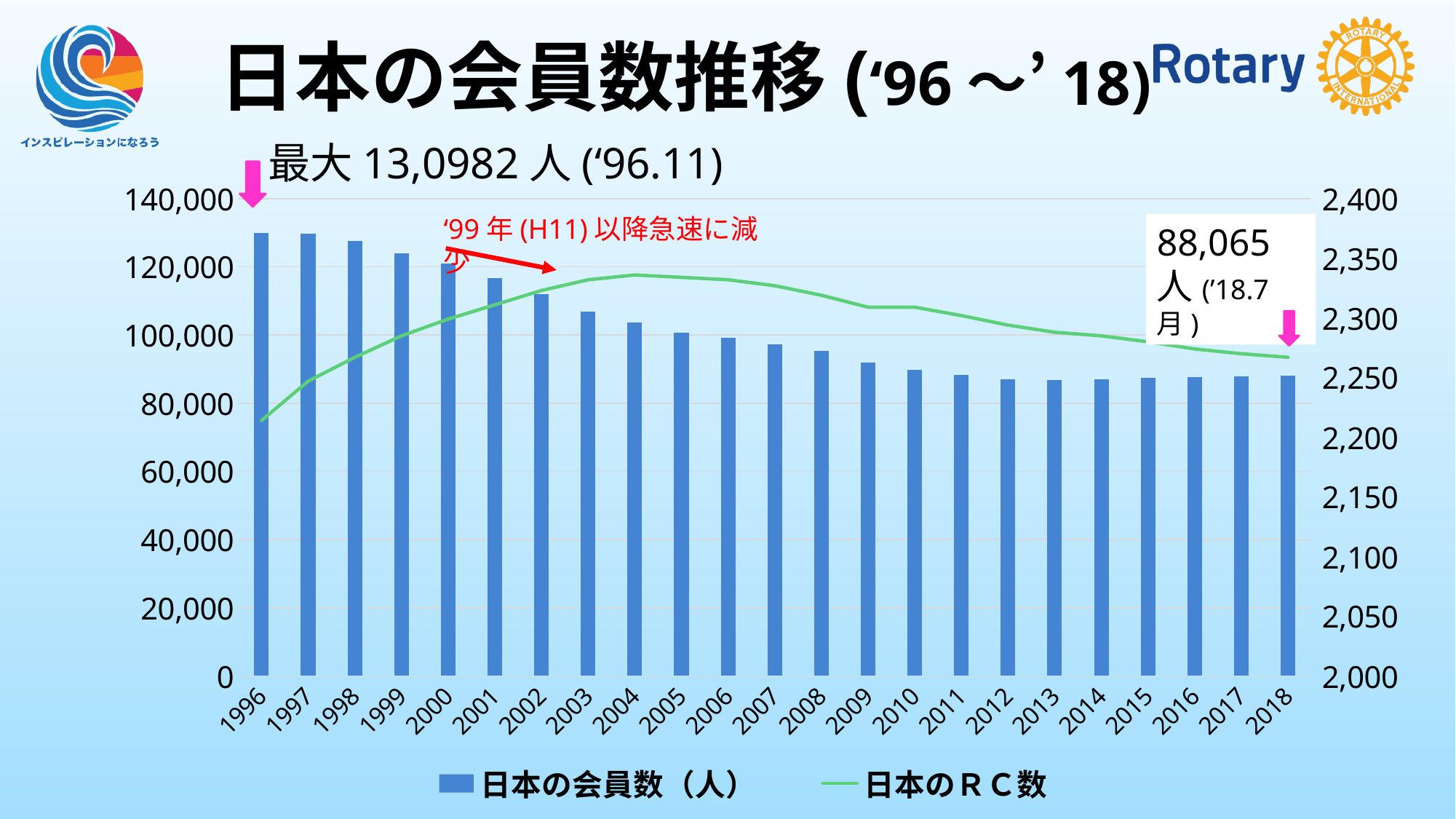
Is the 日本の会員数（人） bar for 1996 greater or less than 120,000? greater Is the 日本の会員数（人） bar for 2018 greater or less than 100,000? less In which year is the 日本のＲＣ数 line at its lowest? 1996 How many series does the legend list? 2 Is the 日本のＲＣ数 value for 2004 greater or less than 2,300? greater How many years are shown along the x axis? 23 Which year has the larger 日本の会員数（人） bar, 2000 or 2005? 2000 What kind of chart is shown on the slide? A combination bar and line chart What is the title of the chart on the slide? 日本の会員数推移 (‘96 ～’ 18) Do the 日本の会員数（人） bars generally rise or fall from 1996 to 2018? fall Which year has the highest bar for 日本の会員数（人）? 1996 In which year does the 日本のＲＣ数 line reach its peak? 2004